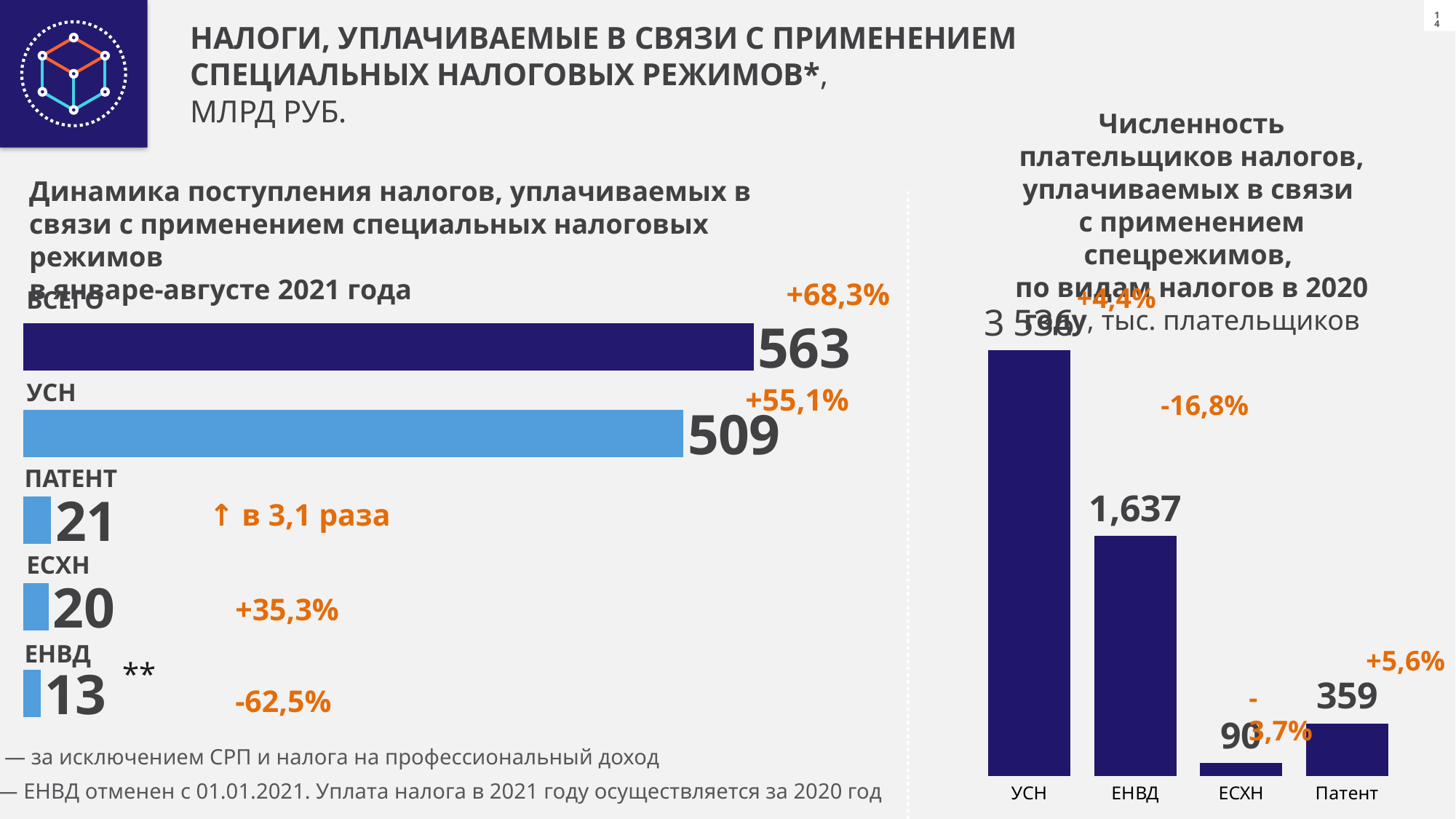
In the left chart, what is the value for ЕНВД? 13 In the left chart, what is the value for ПАТЕНТ? 21 In the right chart, 'Численность плательщиков налогов, уплачиваемых в связи с применением спецрежимов, по видам налогов в 2020 году', what is the value for ЕНВД? 1,637 What kind of chart is the left chart, 'Динамика поступления налогов, уплачиваемых в связи с применением специальных налоговых режимов в январе-августе 2021 года'? bar chart In the left chart, what is the value for ВСЕГО? 563 In the right chart, which category has the lowest value? ЕСХН In the left chart, which category has the lowest value? ЕНВД In the left chart, what is the value for УСН? 509 In the right chart, which category has the highest value? УСН In the right chart, what is the value for Патент? 359 In the left chart, how many categories are shown? 5 In the left chart, what is the difference between the values for ВСЕГО and УСН? 54